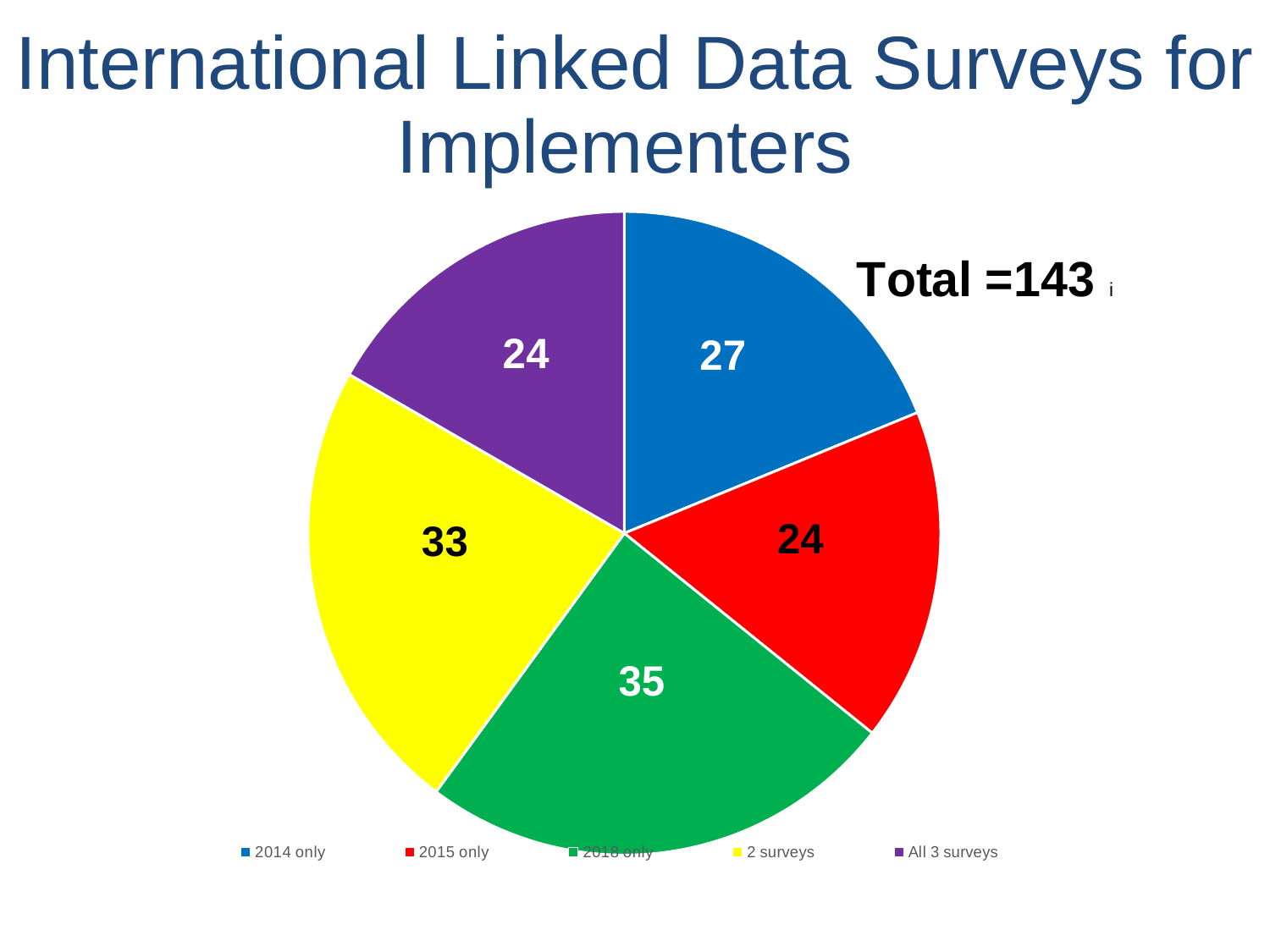
What is the value for the '2015 only' slice? 24 Which is larger, the '2 surveys' slice or the '2014 only' slice? 2 surveys What is the value for the '2014 only' slice? 27 Which category has the largest slice of the pie? 2018 only What is the value for the '2 surveys' slice? 33 What total is stated next to the pie chart? 143 What colour is the 'All 3 surveys' slice? purple What type of chart is shown on the slide? pie chart What is the difference between the '2 surveys' value and the '2014 only' value? 6 What is the difference between the '2018 only' value and the '2015 only' value? 11 What is the value for the 'All 3 surveys' slice? 24 How many slices does the pie chart have? 5